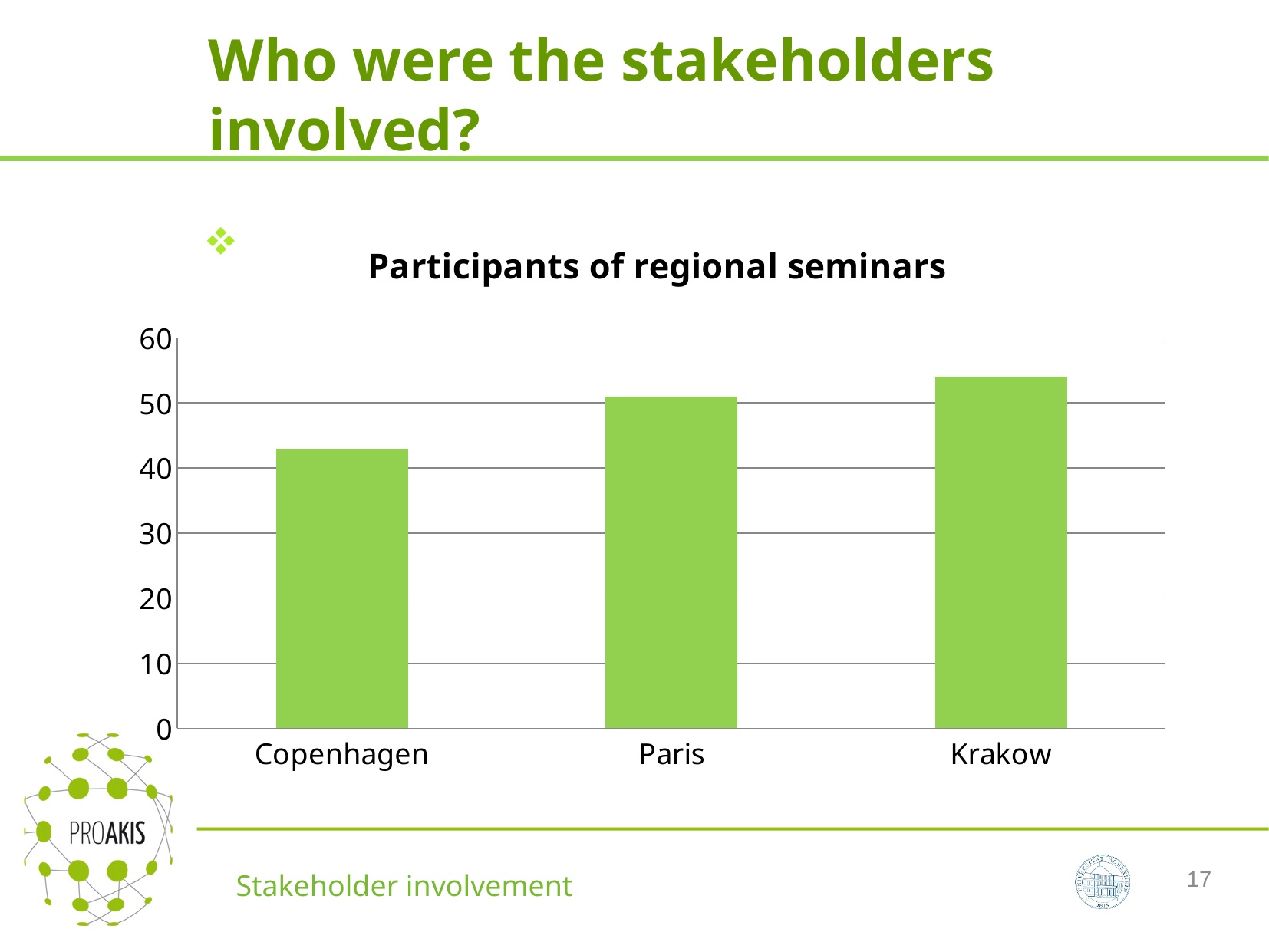
Which has more participants, Copenhagen or Krakow? Krakow Is the value for Paris greater or less than 60? less What kind of chart is shown on the slide? bar chart Is the value for Copenhagen greater or less than 50? less Which city has the highest number of participants? Krakow Which has more participants, Copenhagen or Paris? Paris What is the title of the chart? Participants of regional seminars Do the values rise or fall from Copenhagen to Krakow along the x axis? rise Which city has the lowest number of participants? Copenhagen How many cities are shown on the x axis of the chart? 3 Is the value for Copenhagen greater or less than 40? greater